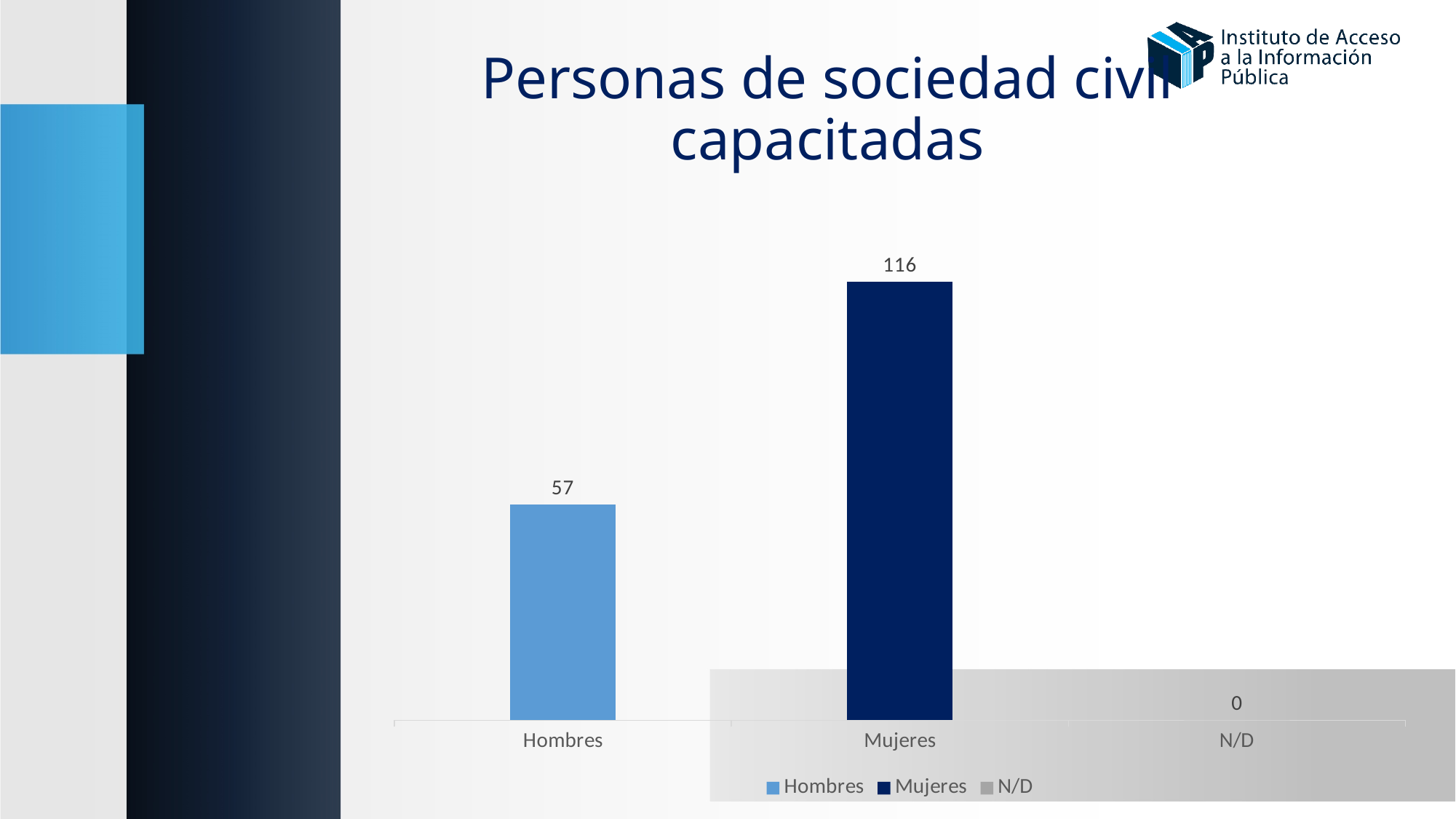
What is the value for Hombres? 57 Which is larger, the value for Hombres or the value for Mujeres? Mujeres What is the value for Mujeres? 116 What is the title of the slide? Personas de sociedad civil capacitadas Which category has the highest value? Mujeres What is the difference between the values for Mujeres and Hombres? 59 What is the total of the values for Hombres, Mujeres and N/D? 173 Which category has the lowest value? N/D What kind of chart is shown on the slide? Bar chart What is the value for N/D? 0 How many entries does the legend list? 3 How many categories are shown on the x axis? 3